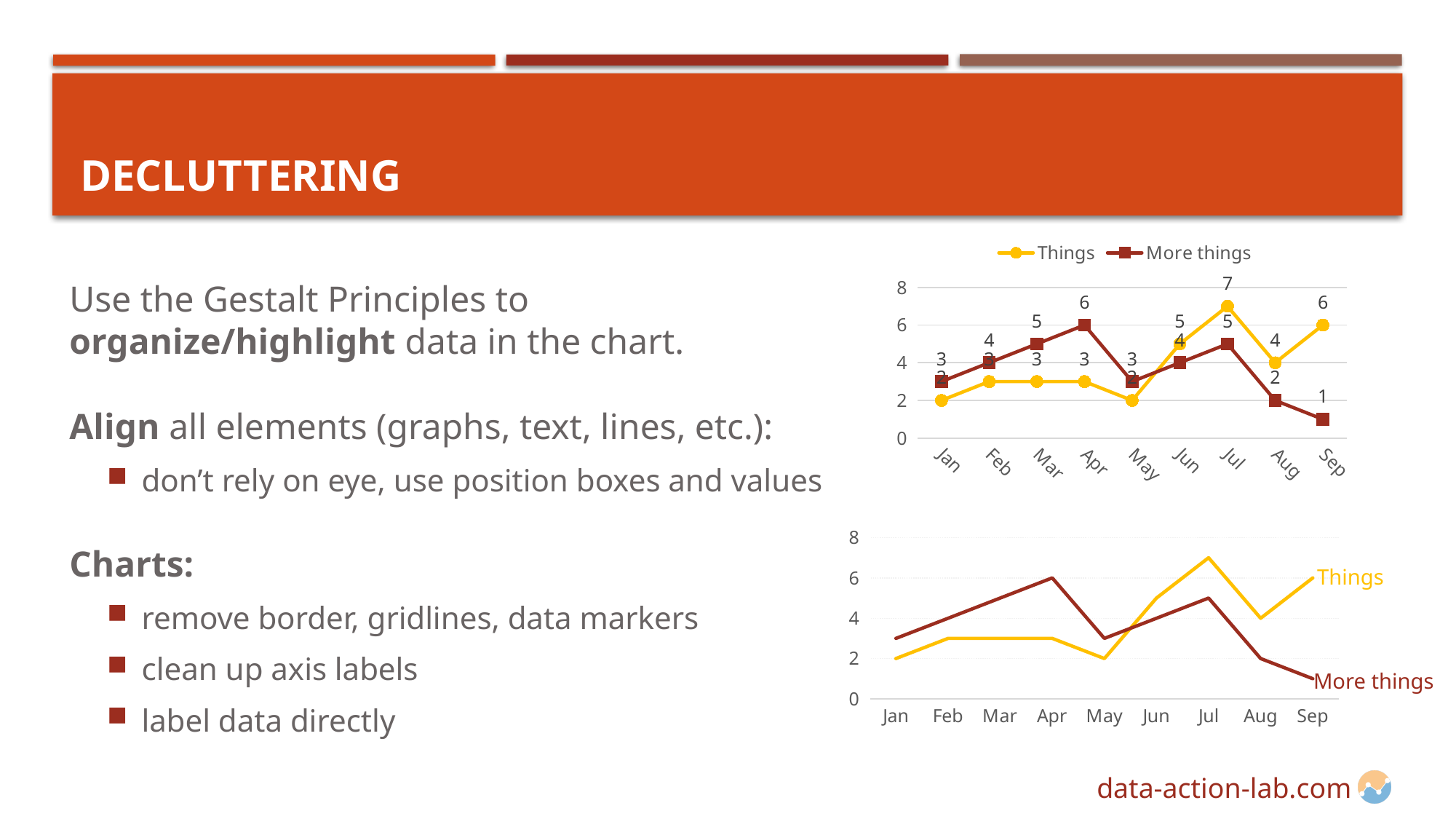
In the bottom chart, does the More things line rise or fall from Jul to Sep? Fall In the top chart, which is larger in Aug, Things or More things? Things In the top chart, what is the value for Things in Jul? 7 In the top chart, in which month is Things highest? Jul In the top chart, what is the difference between Things and More things in Sep? 5 In the top chart, in which month is More things lowest? Sep In the top chart, what is the value for More things in Sep? 1 How many series does the legend of the top chart list? 2 How many months are shown on the x axis of the bottom chart? 9 What kind of chart is the bottom chart? Line chart In the bottom chart, is the value for Things in Jul greater or less than 6? greater In the top chart, what is the value for More things in Apr? 6